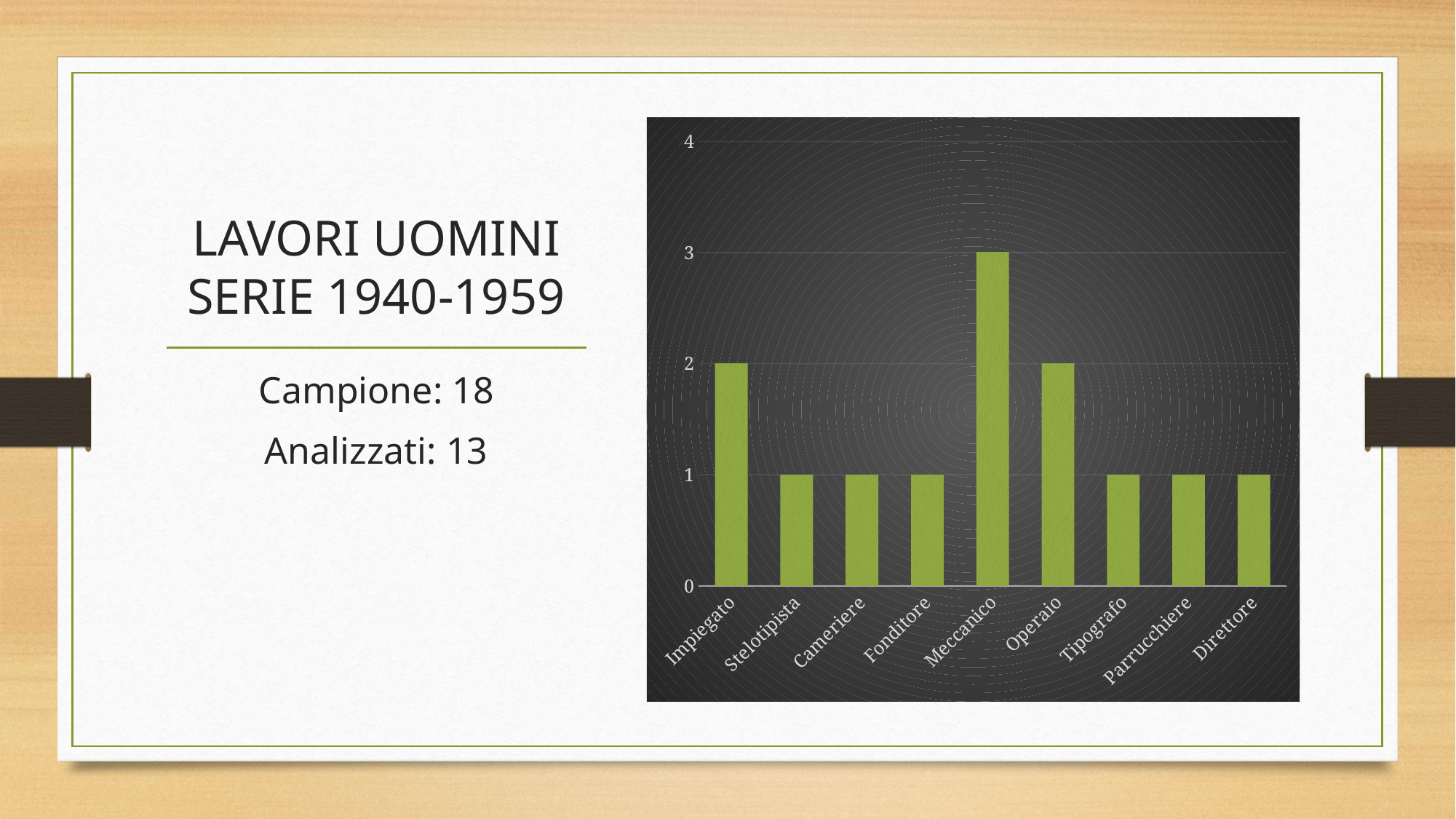
What is the difference between the values for Operaio and Tipografo? 1 What is the value for Impiegato? 2 What type of chart is shown on the slide? Bar chart Is the value for Meccanico greater or less than 2? greater Which is larger, the value for Meccanico or the value for Operaio? Meccanico What is the value for Parrucchiere? 1 Which job has the highest value in the chart? Meccanico How many categories (jobs) are shown on the x axis of the chart? 9 What is the value for Meccanico? 3 What is the value for Operaio? 2 What is the difference between the values for Meccanico and Impiegato? 1 What is the highest value shown on the y axis of the chart? 4